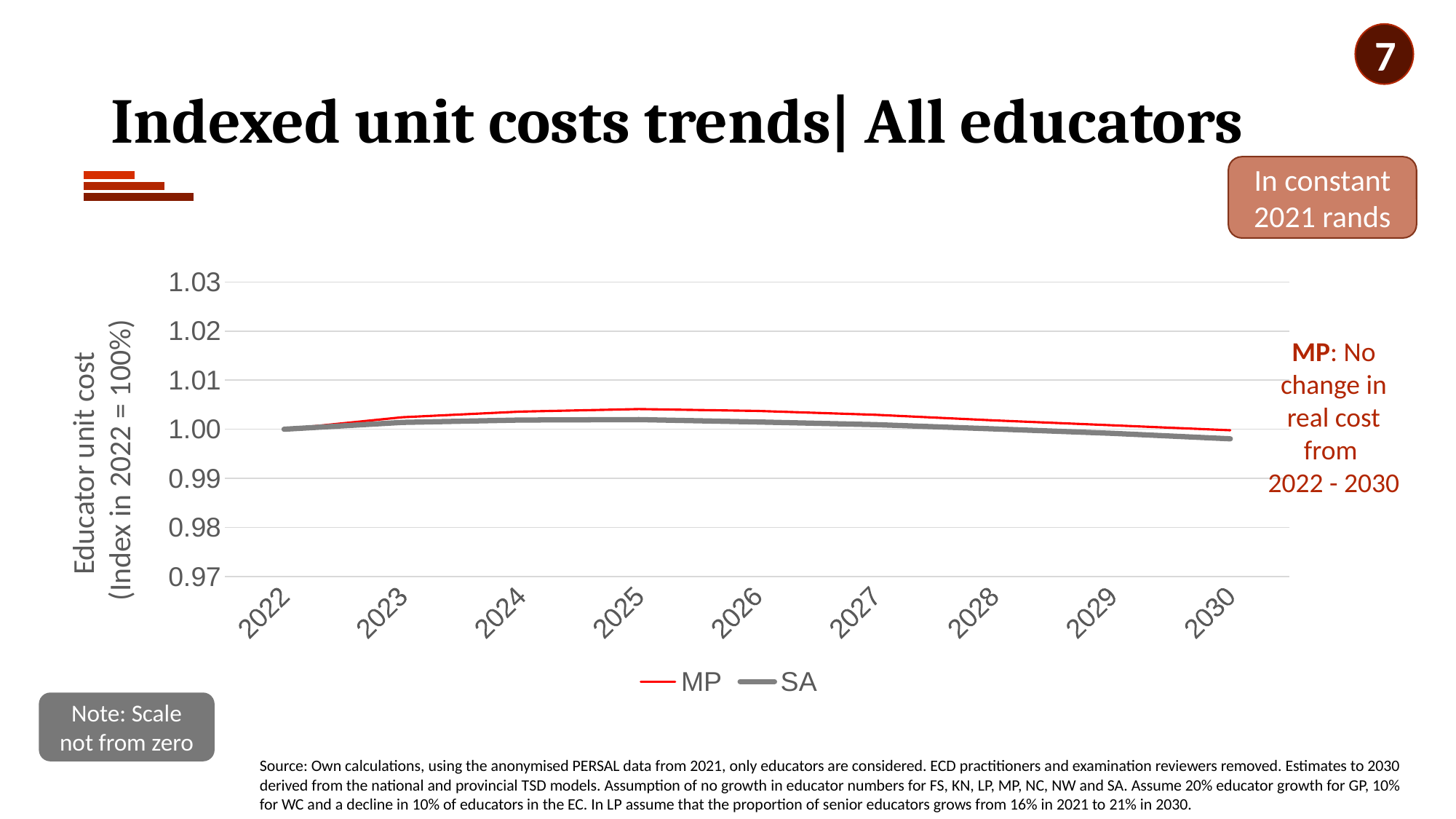
How many series does the legend list? 2 What is the index value for MP in 2022? 1.00 How many years are shown on the x axis? 9 Is the value for MP in 2025 greater or less than 1.01? less Which series is drawn with the thick grey line? SA Does the MP line rise or fall between 2025 and 2030? fall In 2028, which series has the higher value, MP or SA? MP Is the value for SA in 2030 greater or less than 1.00? less What type of chart is shown on the slide? line chart Is the value for MP in 2025 greater or less than 1.00? greater What is the index value for SA in 2022? 1.00